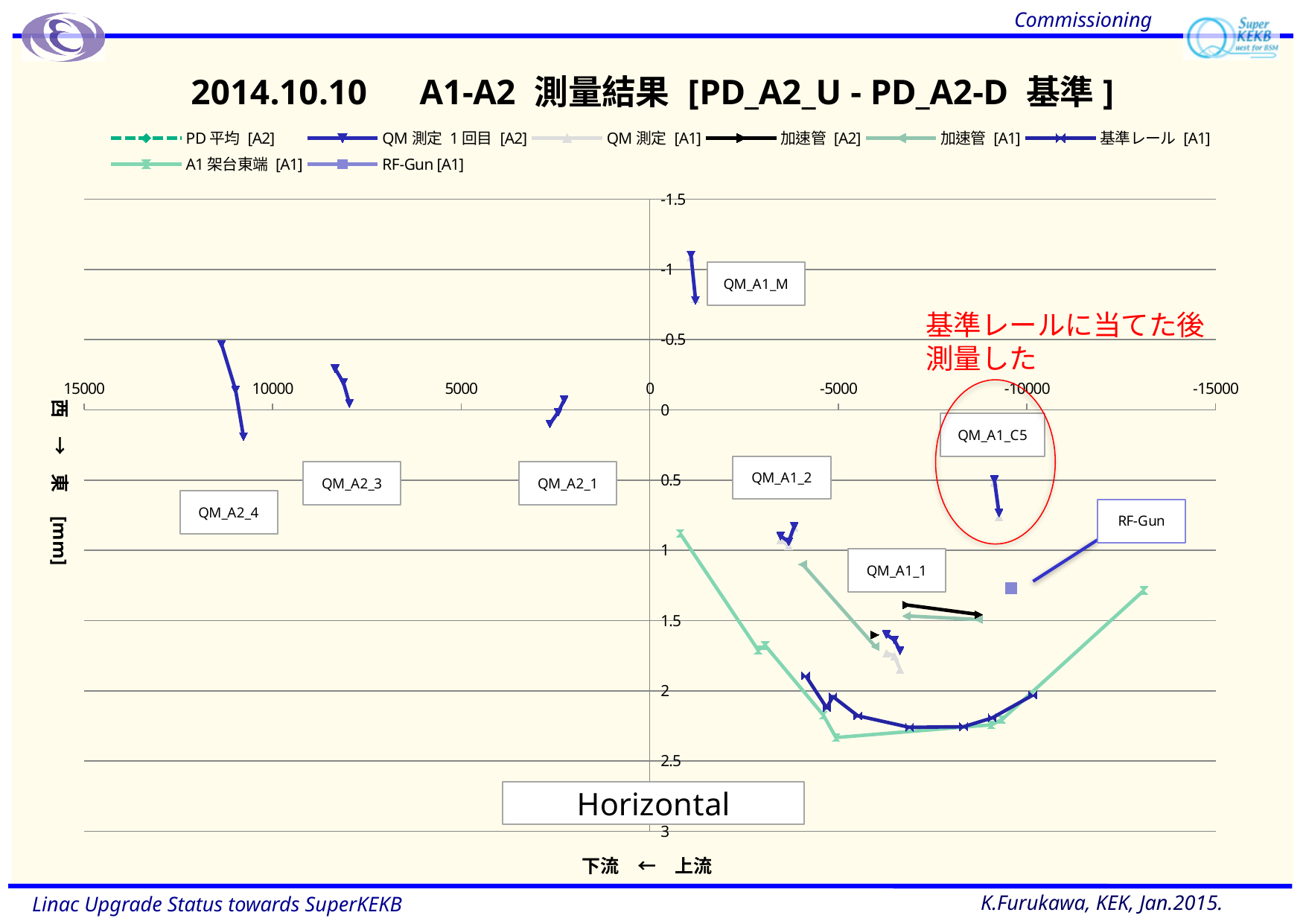
What is the title of the chart? 2014.10.10 A1-A2 測量結果 [PD_A2_U - PD_A2-D 基準] What is the largest value shown on the vertical axis? 3 Is the value for the RF-Gun [A1] point greater or less than 1.5? less What is the smallest value shown on the vertical axis? -1.5 What kind of chart is shown on the slide? line chart Is the value for the QM_A1_M measurement greater or less than 0? less How many series does the chart legend list? 8 How many QM label boxes (labels starting with QM_) are shown on the chart? 7 Is the value for the RF-Gun [A1] point greater or less than 1? greater